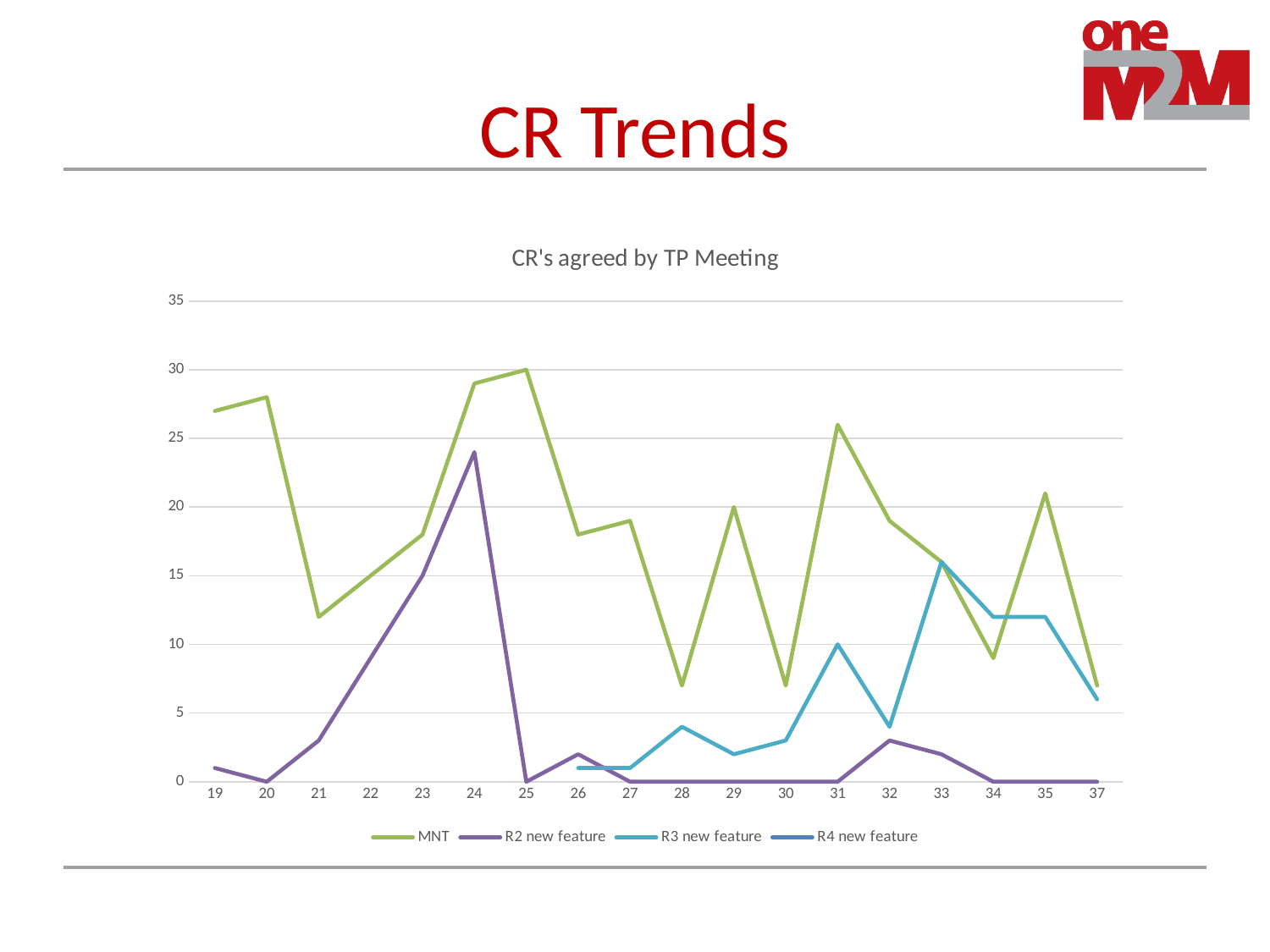
What is the R3 new feature value at TP meeting 31? 10 Is the MNT value at TP meeting 28 greater or less than 10? less What is the title of the chart? CR's agreed by TP Meeting What is the MNT value at TP meeting 29? 20 Is the R2 new feature value at TP meeting 24 greater or less than 20? greater How many series does the legend list? 4 What is the R2 new feature value at TP meeting 25? 0 What kind of chart is shown on the slide? line chart What is the MNT value at TP meeting 25? 30 At which TP meeting does the R2 new feature series reach its highest value? 24 At TP meeting 31, which series has the larger value, MNT or R3 new feature? MNT How many TP meeting numbers are shown on the x axis? 18